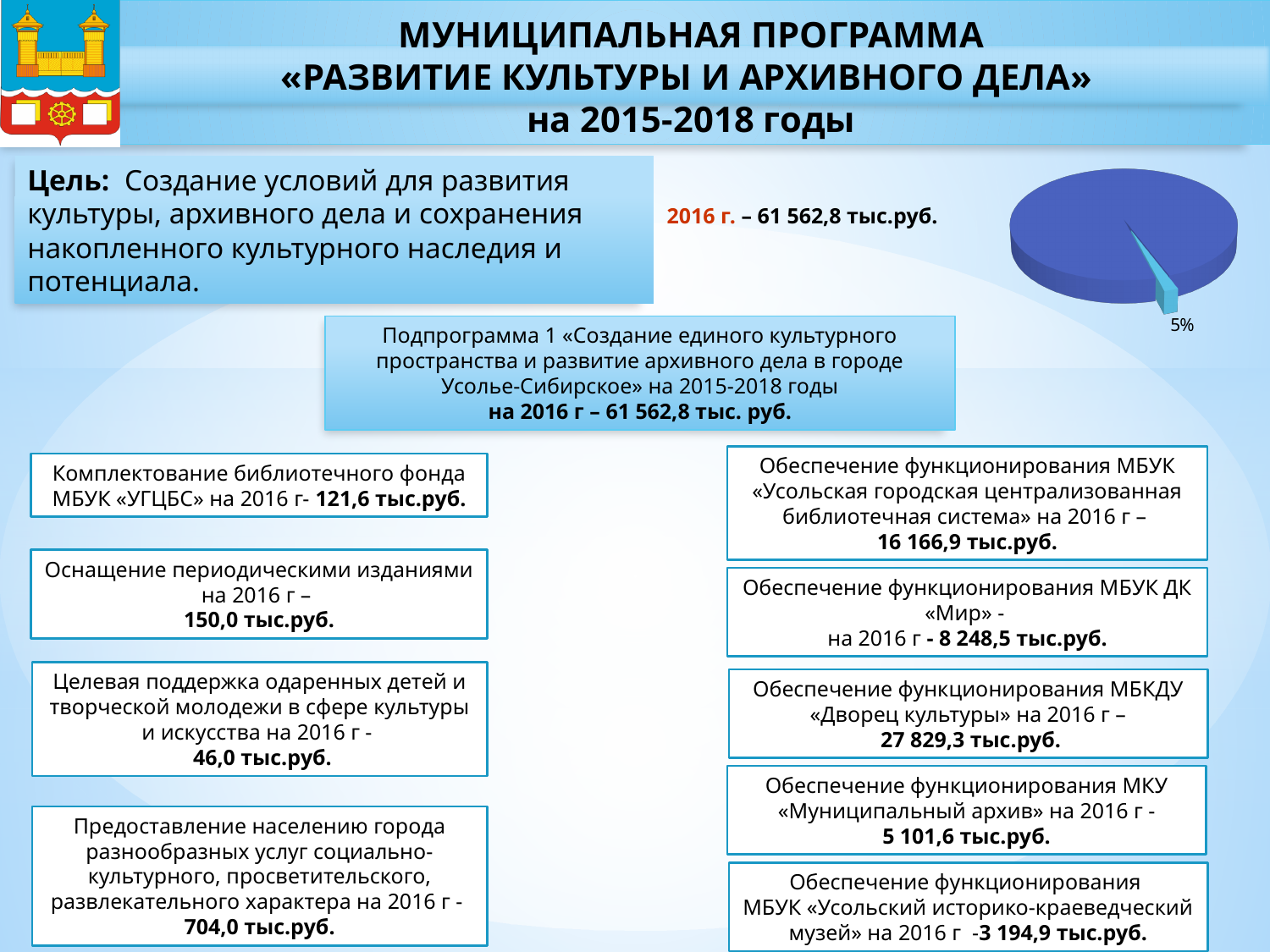
Does the pie chart have a legend? No What kind of chart is shown in the top right of the slide? pie chart How many slices does the pie chart have? 2 Is the slice labelled 5% the larger or the smaller slice of the pie chart? smaller Is the share of the slice labelled 5% greater or less than 50%? less What percentage label is printed on the small slice of the pie chart? 5% What colour is the large slice of the pie chart? blue